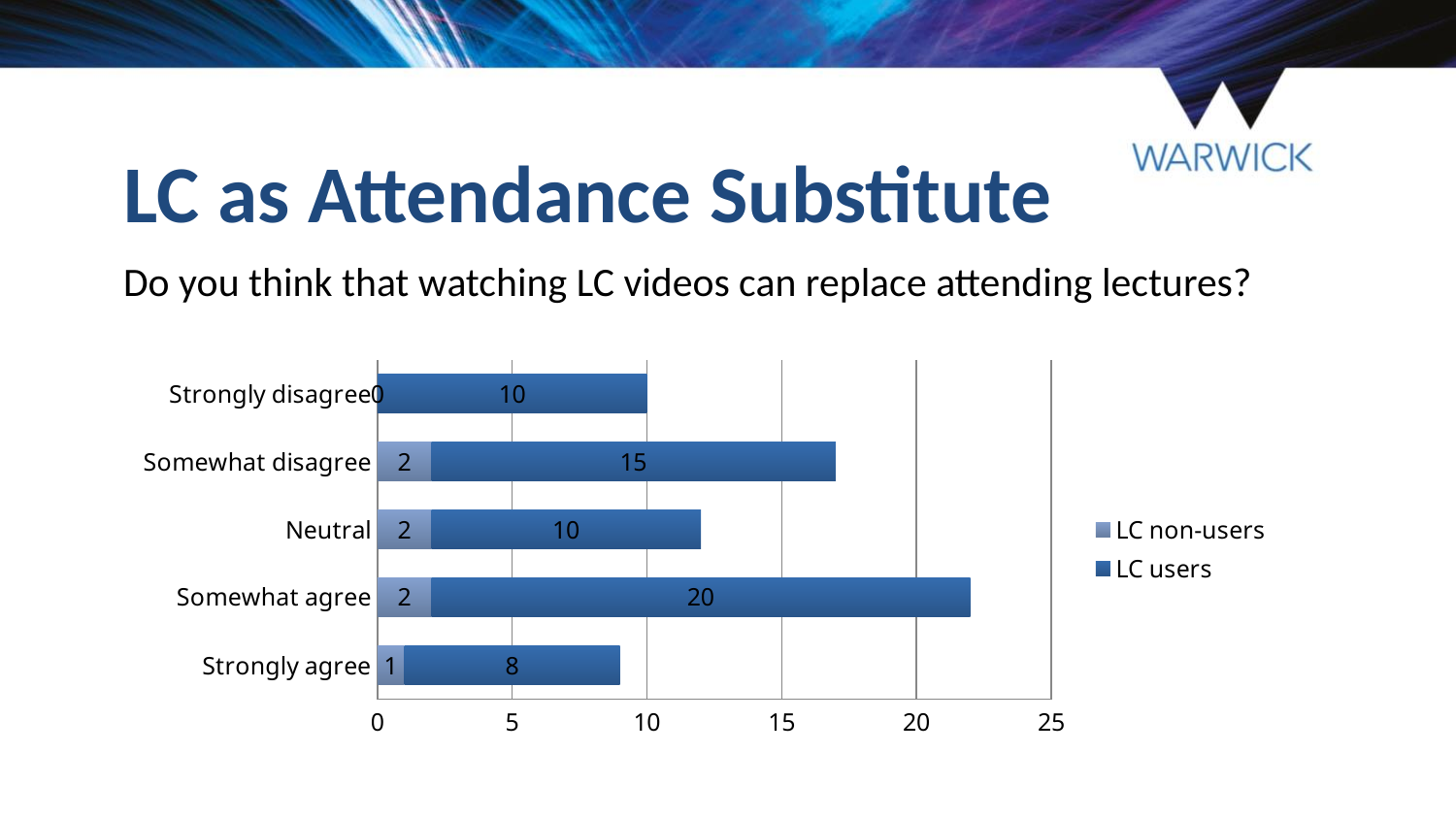
Which category has the lowest value for LC users? Strongly agree What is the value for LC non-users in the Strongly agree category? 1 What is the value for LC users in the Somewhat agree category? 20 Which category has the highest value for LC users? Somewhat agree What kind of chart is shown on the slide? Stacked bar chart What is the value for LC users in the Strongly disagree category? 10 What is the difference between the LC users values for Somewhat agree and Somewhat disagree? 5 How many series does the legend list? 2 Which is larger for LC users: Neutral or Somewhat disagree? Somewhat disagree What is the total of the stacked bar for Strongly agree? 9 What is the total of the stacked bar for Somewhat disagree? 17 How many categories are shown on the chart? 5